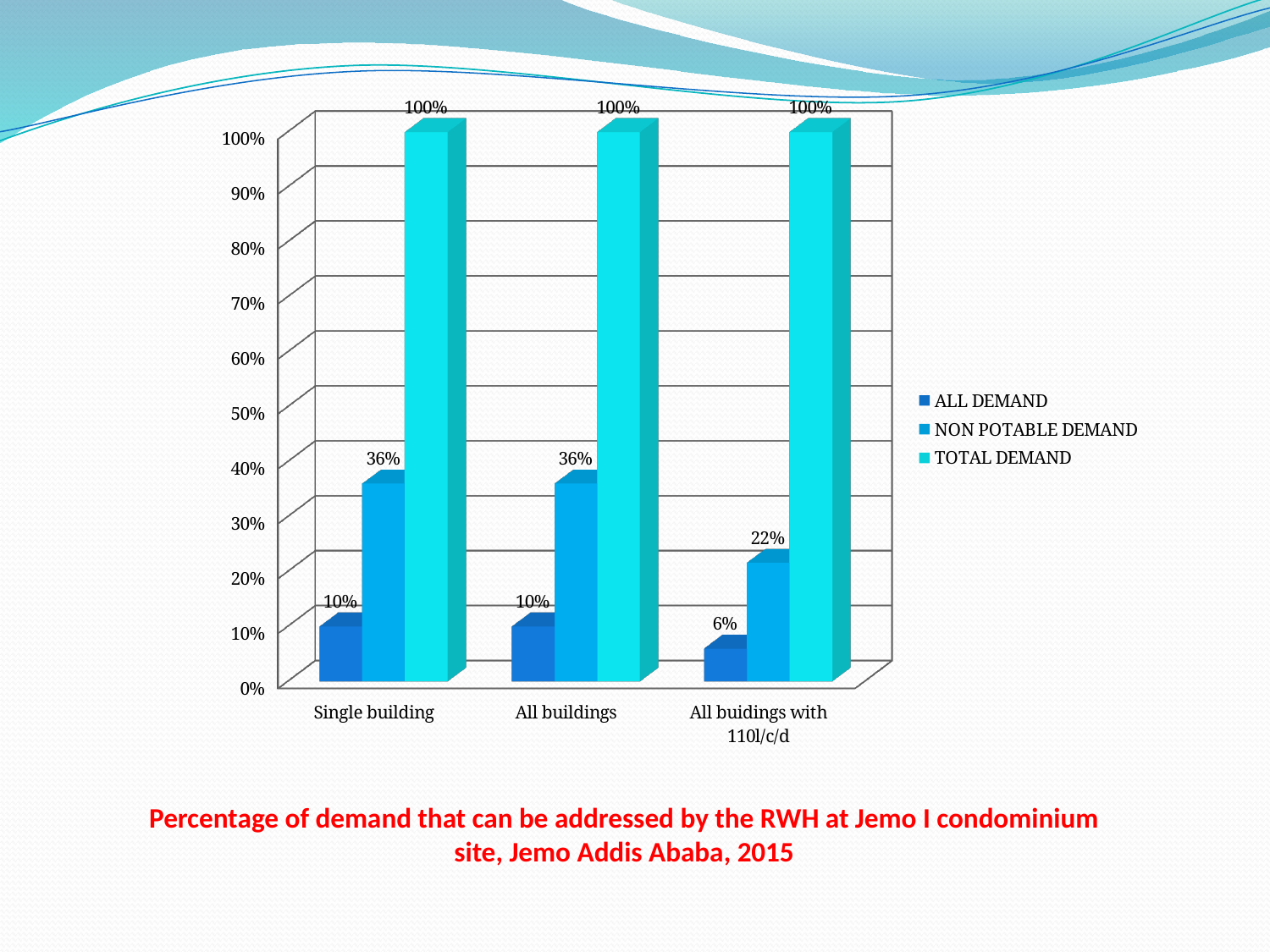
How many series does the legend list? 3 What is the value of TOTAL DEMAND for All buildings? 100% Which category has the lowest NON POTABLE DEMAND value? All buidings with 110l/c/d What kind of chart is shown on the slide? Bar chart How many categories are shown on the x axis? 3 What is the value of ALL DEMAND for Single building? 10% Which is larger for All buidings with 110l/c/d: ALL DEMAND or NON POTABLE DEMAND? NON POTABLE DEMAND What is the difference between NON POTABLE DEMAND and ALL DEMAND for Single building? 26% What is the value of NON POTABLE DEMAND for All buidings with 110l/c/d? 22% What is the value of NON POTABLE DEMAND for All buildings? 36% What is the difference between the NON POTABLE DEMAND values for All buildings and All buidings with 110l/c/d? 14% Which category has the lowest ALL DEMAND value? All buidings with 110l/c/d